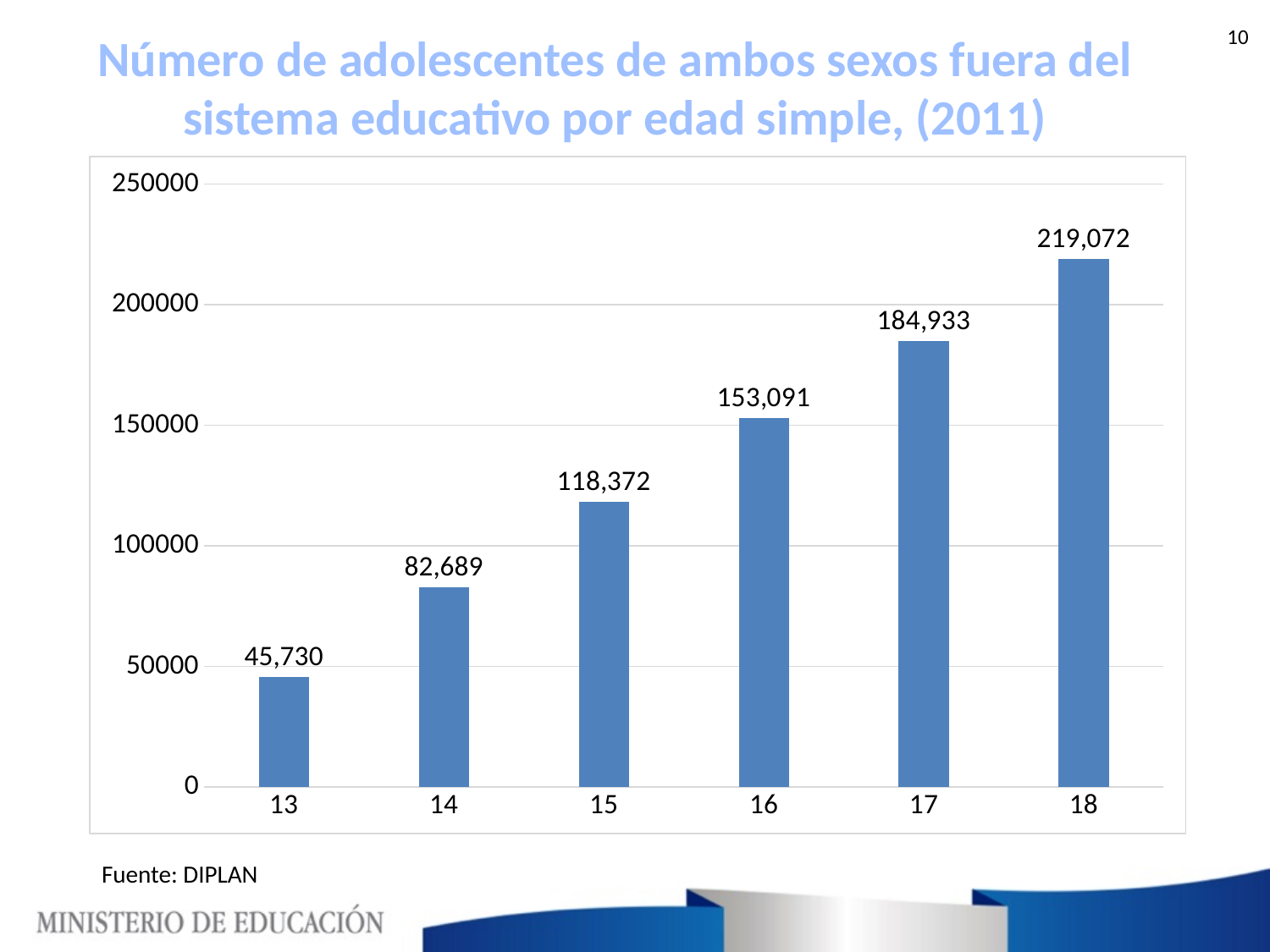
How many age categories are shown on the x axis? 6 Which is larger, the value for age 15 or the value for age 16? 16 Do the values rise or fall as age increases along the x axis? rise What is the value for age 16? 153,091 What kind of chart is shown on the slide? bar chart What is the value for age 13? 45,730 What is the value for age 18? 219,072 Which age has the lowest value? 13 Is the value for age 17 greater or less than 200000? less Which age has the highest value? 18 What is the difference between the values for age 18 and age 17? 34,139 What is the difference between the values for age 15 and age 14? 35,683